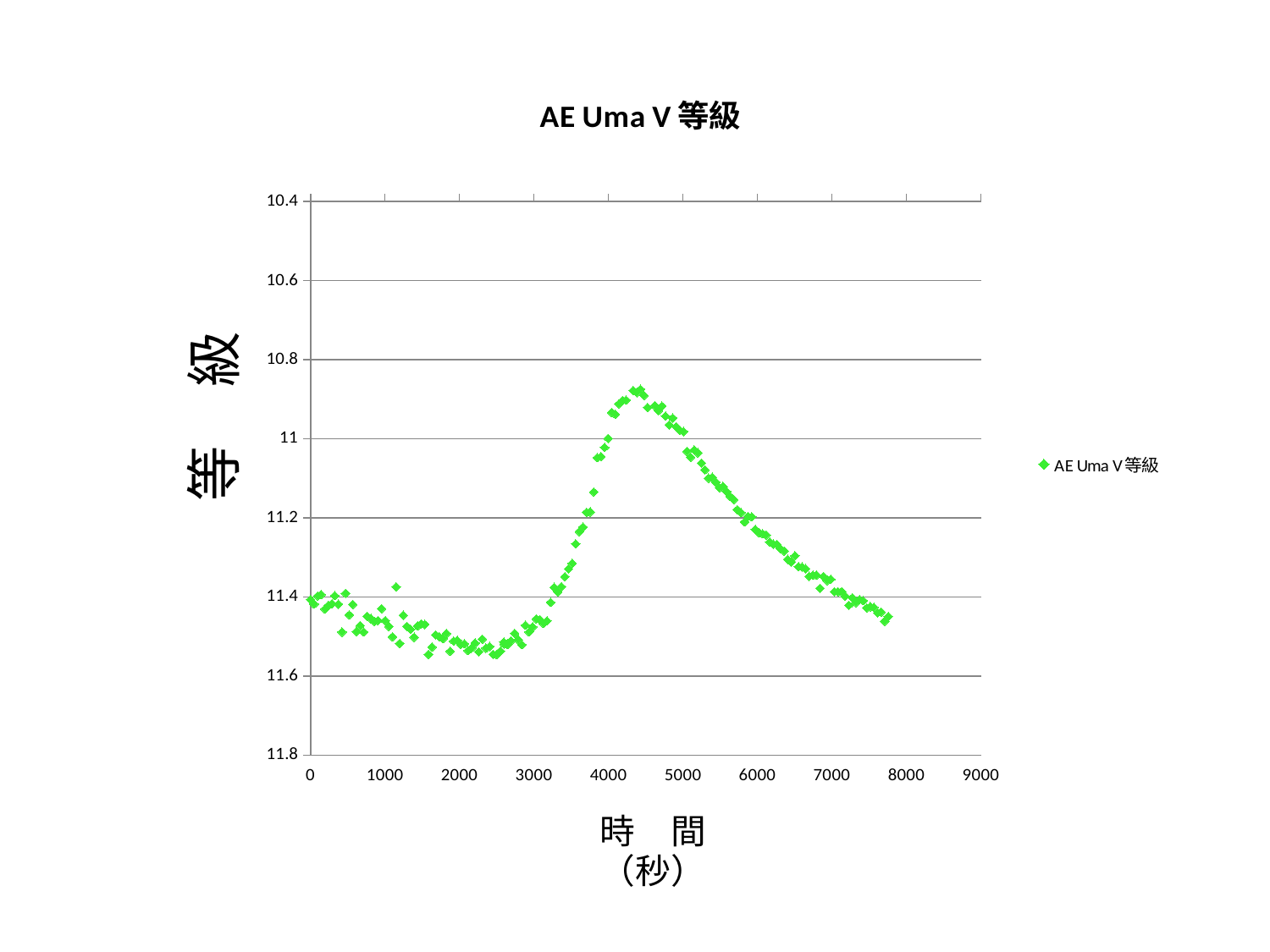
Which has the numerically larger plotted value: the point at about 2000 seconds or the point at about 4400 seconds? the point at about 2000 seconds What is the title of the chart? AE Uma V 等級 Between about 5000 and 7500 seconds, do the plotted magnitude values numerically increase or decrease? increase Is the plotted value at about 2000 seconds greater or less than 11.4? greater Between about 3000 and 4400 seconds, do the plotted magnitude values numerically increase or decrease? decrease Is the plotted value at about 4400 seconds greater or less than 11? less How many series does the legend list? 1 Is the plotted value at about 1000 seconds greater or less than 11.2? greater What kind of chart is shown on the slide? scatter chart What is the label of the x axis? 時 間（秒）